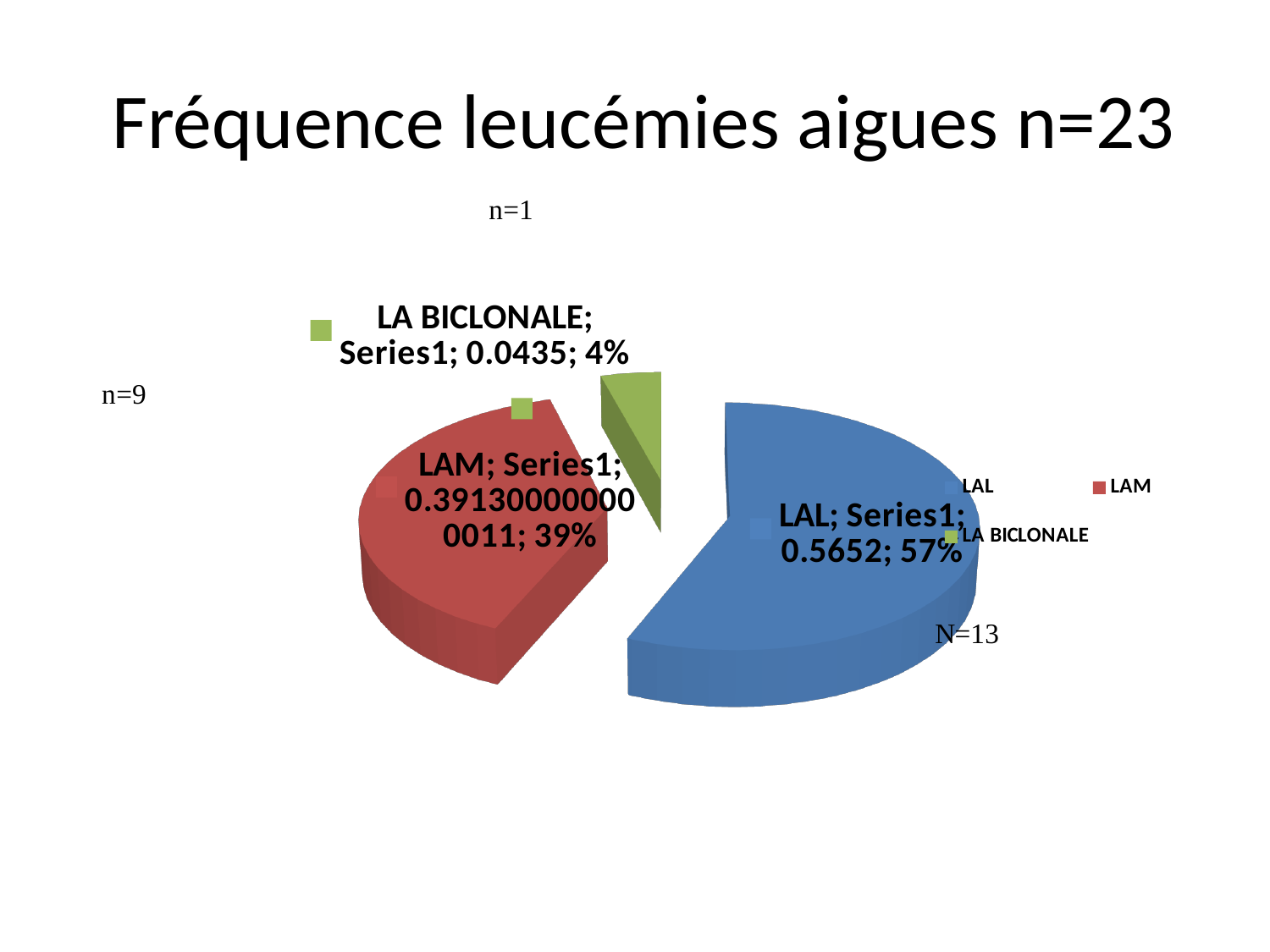
What percentage share does the LAL slice have? 57% What colour is the LAL slice of the pie chart? blue How many slices does the pie chart have? 3 What percentage share does the LAM slice have? 39% What is the difference in percentage points between the LAM and LA BICLONALE slices? 35 Which category has the largest slice of the pie? LAL Which category has the smallest slice of the pie? LA BICLONALE What kind of chart is shown on the slide? pie chart What is the difference in percentage points between the LAL and LAM slices? 18 Which slice is larger, LAM or LA BICLONALE? LAM What is the title of the slide containing the pie chart? Fréquence leucémies aigues n=23 What percentage share does the LA BICLONALE slice have? 4%